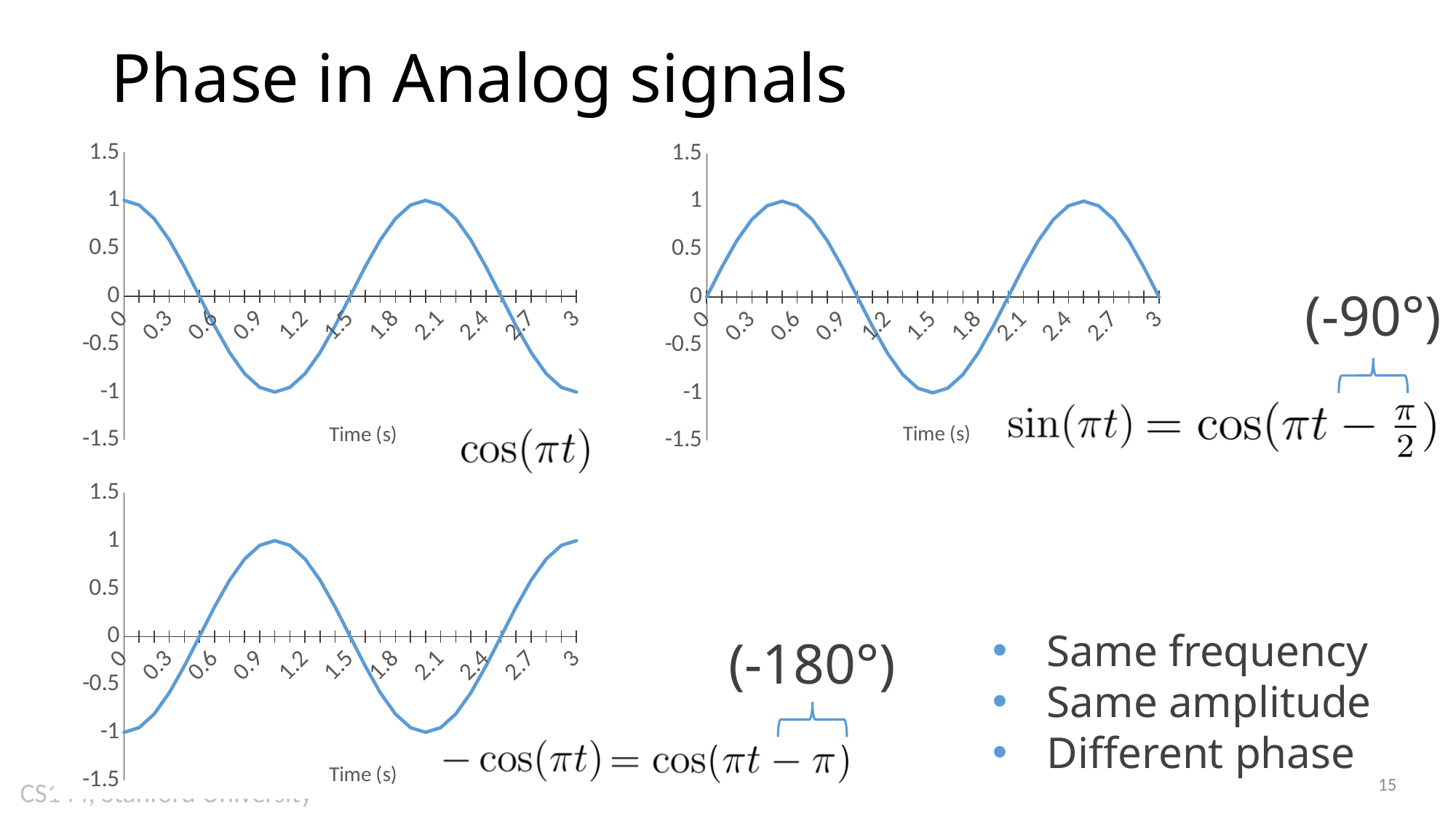
What kind of chart is the top-left chart on the slide? line chart In the top-right chart, is the value at time 0.6 greater or less than 0.5? greater What is the highest tick value shown on the y axis of the top-left chart? 1.5 In the top-left chart, is the value at time 0.9 greater or less than -0.5? less In the top-right chart (sin(πt)), what is the value at time 0? 0 In the bottom-left chart (−cos(πt)), what is the value at time 0? -1 In the top-left chart (cos(πt)), what is the value at time 0? 1 In the top-left chart, does the line rise or fall between time 0 and time 0.9? fall In the bottom-left chart, does the line rise or fall between time 0 and time 0.9? rise In the bottom-left chart, is the value at time 2.1 greater or less than -0.5? less How many charts are shown on the slide? 3 What is the x-axis label of the top-right chart? Time (s)